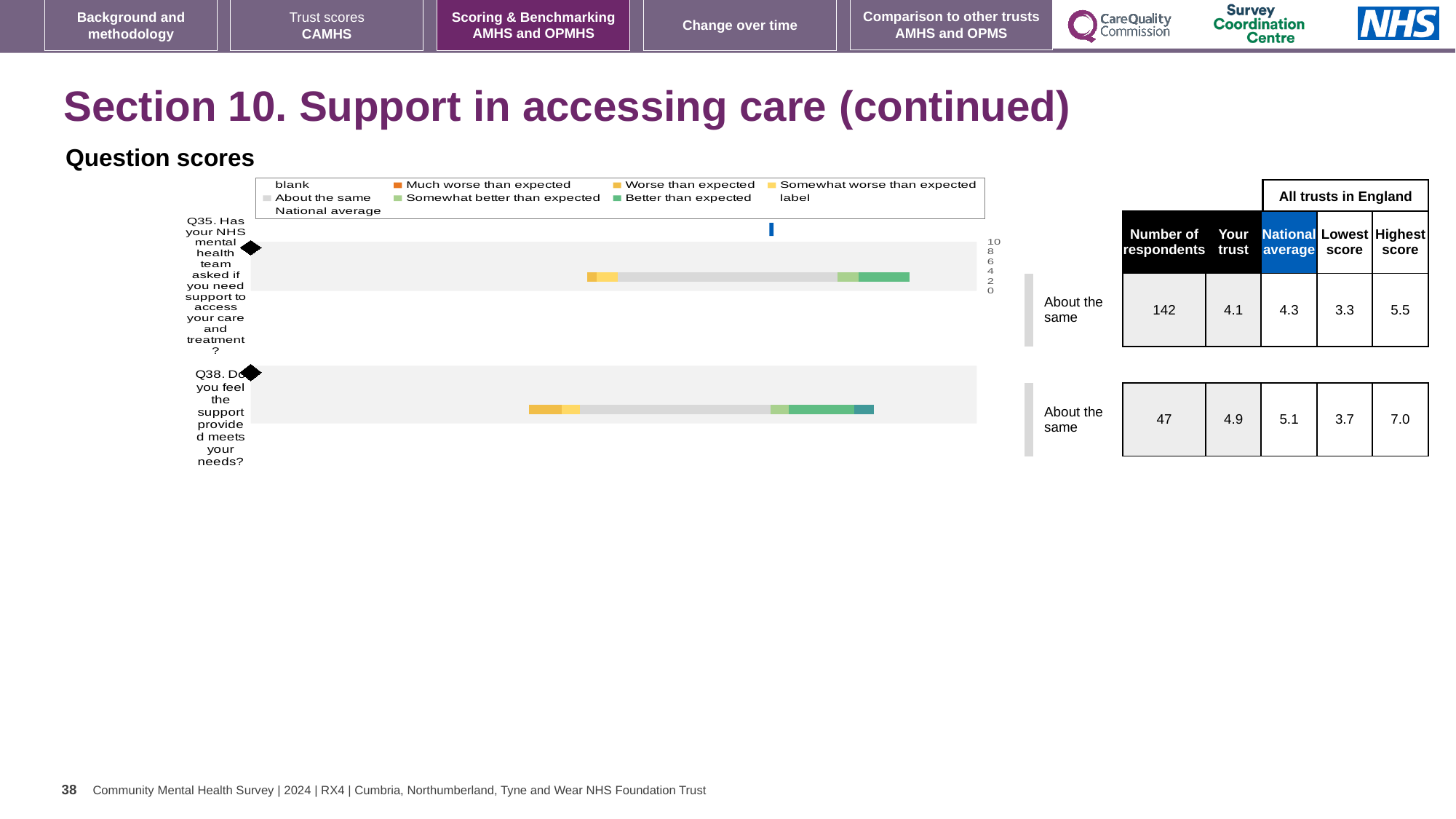
What is the highest score among all trusts in England for Q38? 7.0 Which question has the higher 'Your trust' score, Q35 or Q38? Q38 How many questions are plotted in the question scores chart? 2 What is the difference between the highest and lowest scores for Q38? 3.3 What is the number of respondents for Q35? 142 What is the national average score for Q35? 4.3 What kind of chart is used to show the question scores on this slide? Bar chart What is the lowest score among all trusts in England for Q35? 3.3 What colour represents 'Better than expected' in the chart legend? Green For Q38, which is higher: the trust's score or the national average? National average What is the 'Your trust' score for Q38? 4.9 What benchmark category is shown for Q35? About the same